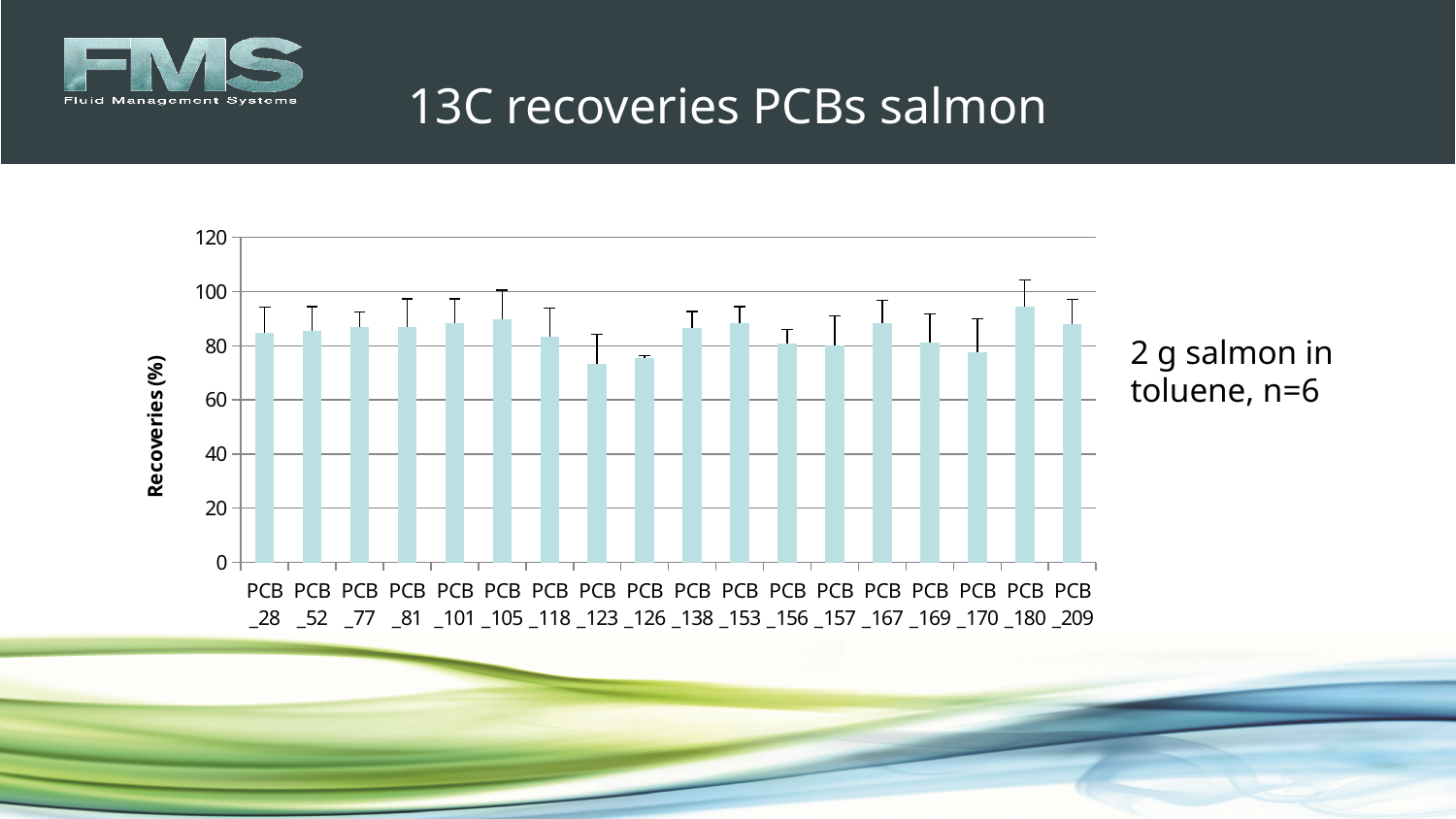
Which has the higher recovery, PCB_170 or PCB_180? PCB_180 Which has the higher recovery, PCB_105 or PCB_123? PCB_105 Which PCB congener has the highest recovery on the chart? PCB_180 Is the recovery for PCB_28 greater or less than 80? greater Is the recovery for PCB_123 greater or less than 80? less Is the recovery for PCB_180 greater or less than 80? greater How many PCB congeners are plotted on the chart? 18 What kind of chart is shown on the slide? Bar chart What is the title of the slide containing the chart? 13C recoveries PCBs salmon What is the label on the vertical axis of the chart? Recoveries (%)